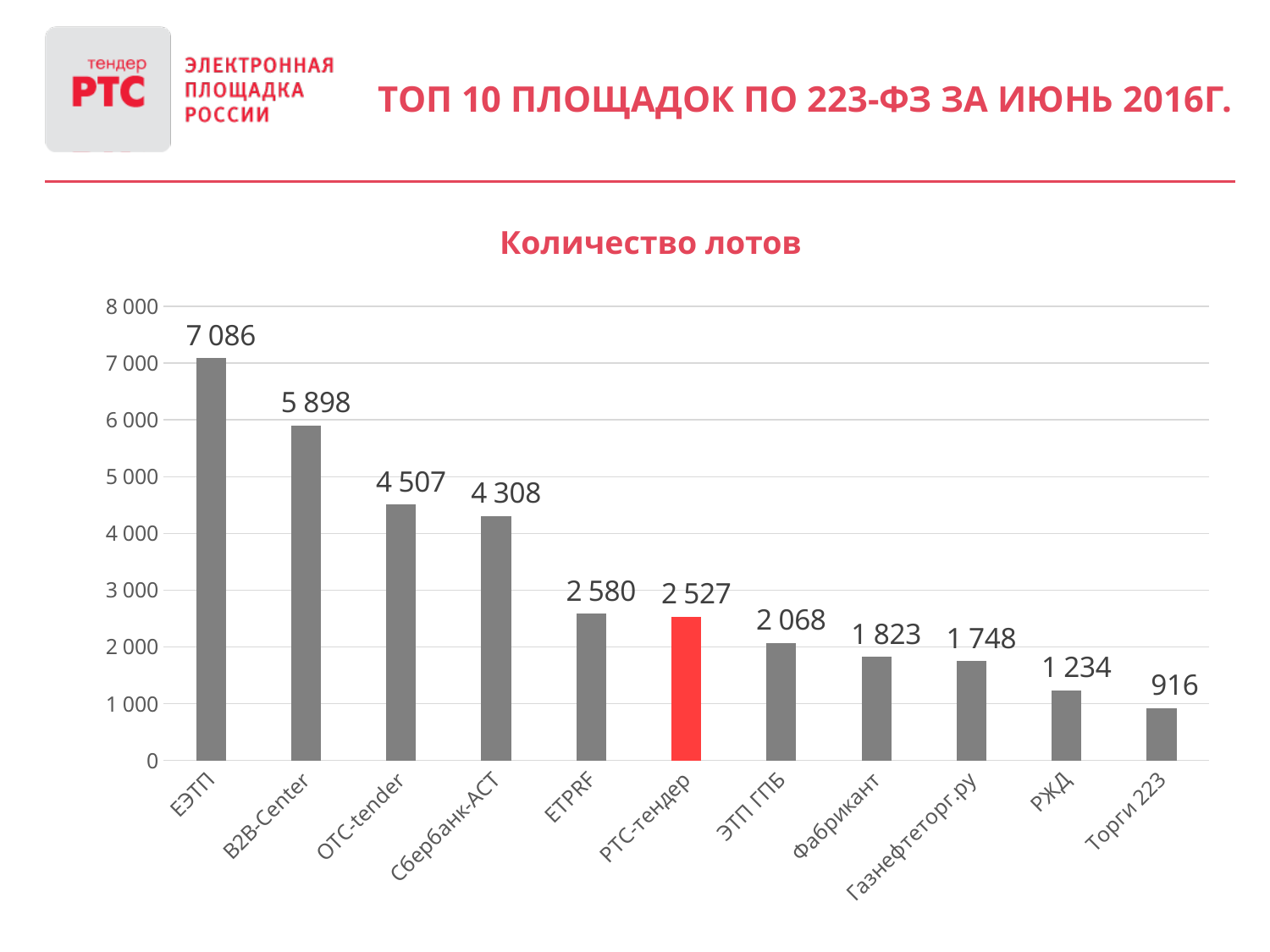
Which is larger, the value for ETPRF or the value for РТС-тендер? ETPRF What is the value for ЕЭТП in the chart? 7 086 What is the difference between the values for ЕЭТП and B2B-Center? 1 188 Which category has the highest value in the chart? ЕЭТП What is the difference between the values for OTC-tender and Сбербанк-АСТ? 199 Which bar in the chart is highlighted in red? РТС-тендер Which category has the lowest value in the chart? Торги 223 What kind of chart is shown on the slide? bar chart Is the value for Фабрикант greater or less than 2 000? less How many categories are shown in the chart? 11 What is the value for РТС-тендер in the chart? 2 527 What is the value for Газнефтеторг.ру in the chart? 1 748